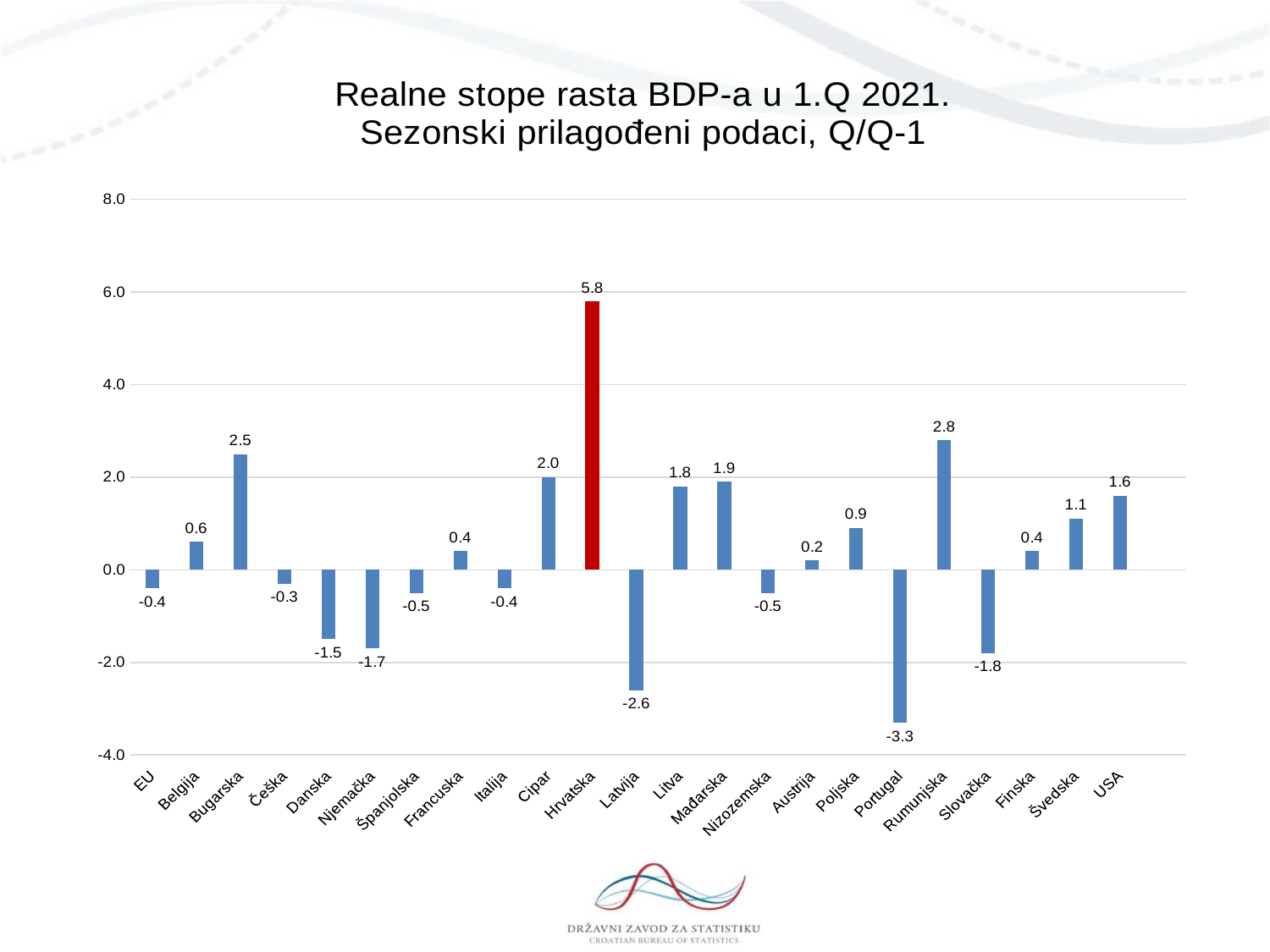
What is the value for Hrvatska? 5.8 What is the value for Rumunjska? 2.8 Which bar is coloured red instead of blue? Hrvatska Which category has the highest value? Hrvatska Is the value for Latvija greater or less than -2.0? less What is the value for EU? -0.4 What kind of chart is shown on the slide? bar chart What is the value for Portugal? -3.3 Which category has the lowest value? Portugal How many categories are shown on the x axis? 23 Which is larger, the value for Bugarska or the value for Cipar? Bugarska What is the difference between the values for Hrvatska and Rumunjska? 3.0